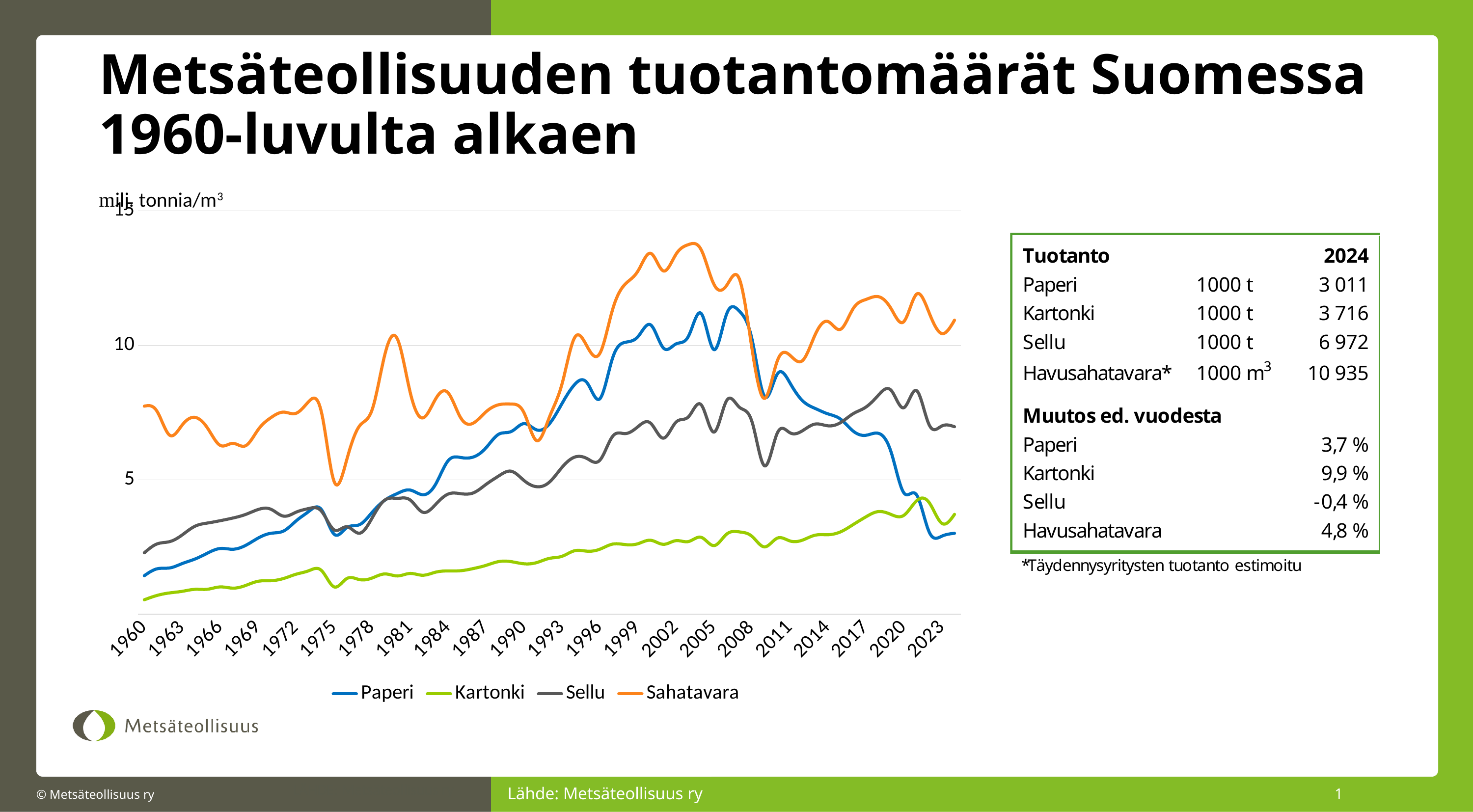
Is the value for Kartonki in 1960 greater or less than 5? less Is the value for Sahatavara in 2024 greater or less than 10? greater Which series has the highest value in 2024? Sahatavara What kind of chart is shown on the slide? line chart Is the value for Sellu in 2024 greater or less than 5? greater What unit is shown above the y axis of the chart? milj. tonnia/m³ Does the Paperi series rise or fall from 2008 to 2024? fall Which series has the lowest value in 1960? Kartonki How many series does the chart legend list? 4 Does the Kartonki series rise or fall from 1960 to 2024? rise Which series are listed in the chart legend? Paperi, Kartonki, Sellu, Sahatavara